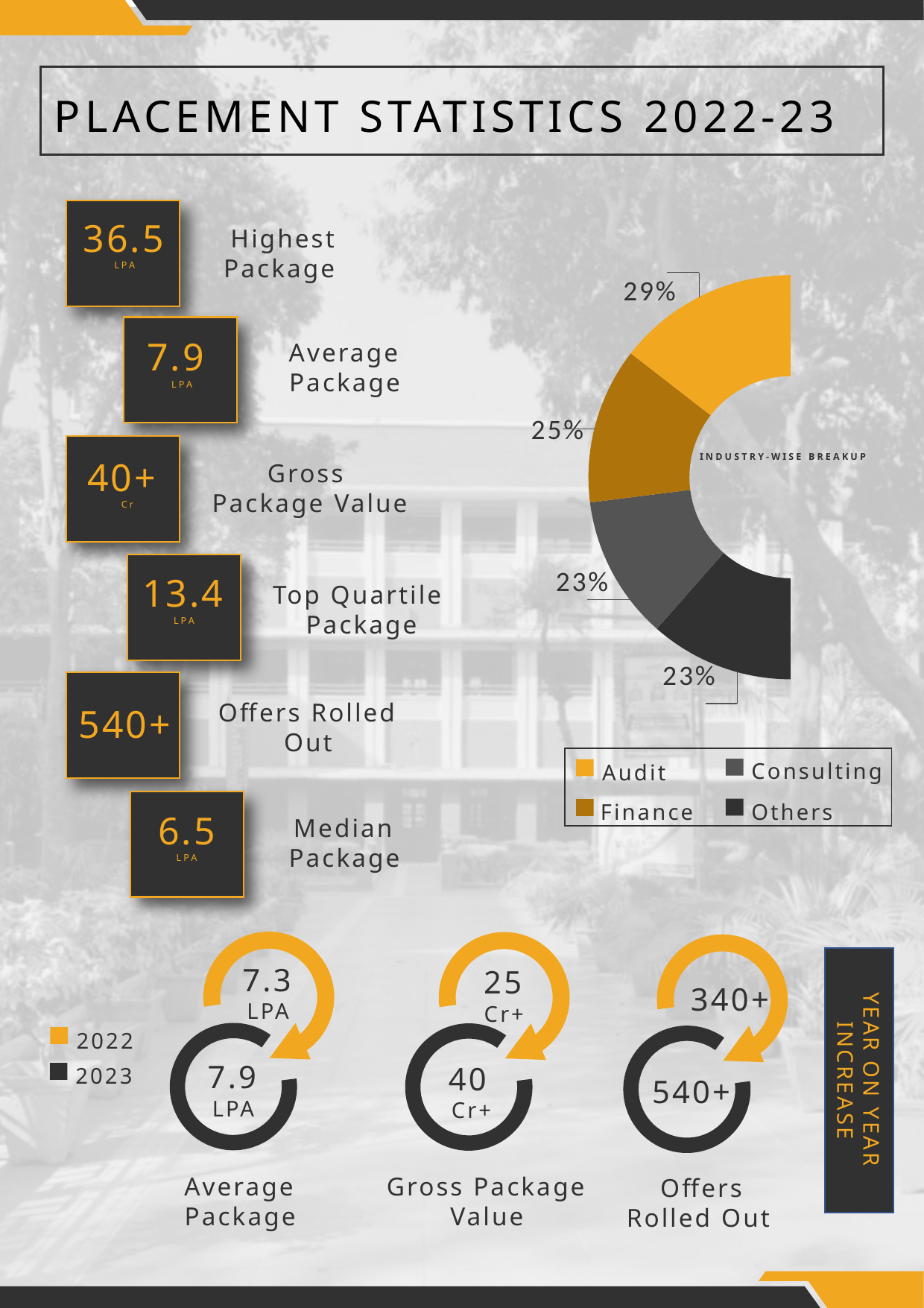
In the Industry-wise Breakup chart, which industry has the largest share? Audit In the Industry-wise Breakup chart, what percentage does Audit account for? 29% In the Industry-wise Breakup chart, what is the share for Finance? 25% In the Industry-wise Breakup chart, how many percentage points larger is Audit's share than Finance's? 4 percentage points In the Year on Year Increase section, what was the Average Package in 2022? 7.3 LPA In the Industry-wise Breakup chart, what is the combined share of Consulting and Others? 46% In the Industry-wise Breakup chart, which is larger, the share for Audit or the share for Others? Audit In the Industry-wise Breakup chart, what percentage is shown for Consulting? 23% What type of chart is the Industry-wise Breakup chart? Pie (donut) chart What colour represents Audit in the Industry-wise Breakup chart legend? Yellow/orange In the Year on Year Increase section, what was the Gross Package Value in 2023? 40 Cr+ How many industry categories are shown in the Industry-wise Breakup chart? 4